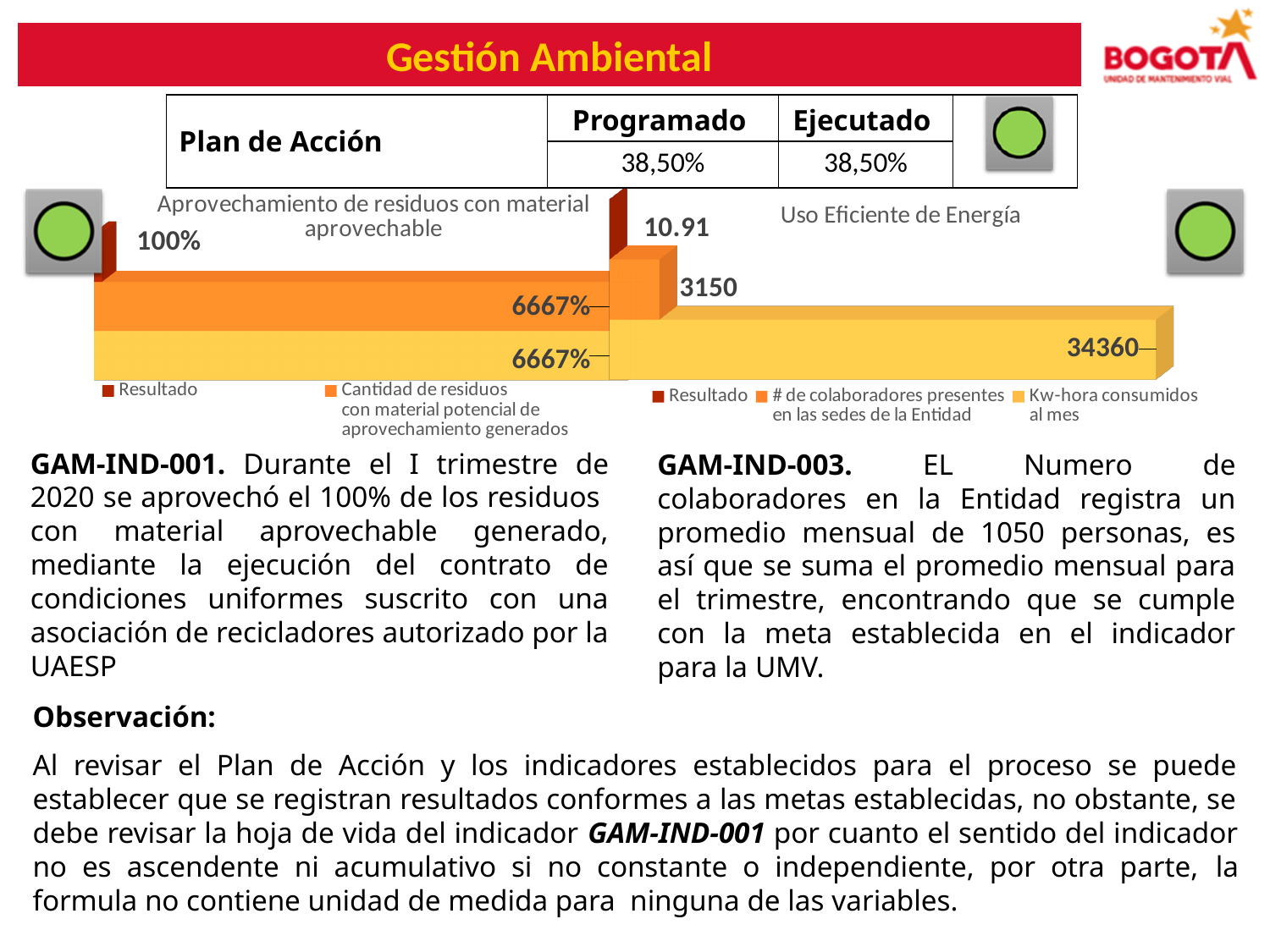
What kind of chart is the chart titled 'Aprovechamiento de residuos con material aprovechable'? Bar chart What is the title of the chart on the right side of the slide? Uso Eficiente de Energía In the chart titled 'Uso Eficiente de Energía', what is the value for 'Resultado'? 10.91 In the chart titled 'Uso Eficiente de Energía', what is the difference between 'Kw-hora consumidos al mes' and '# de colaboradores presentes en las sedes de la Entidad'? 31210 In the chart titled 'Uso Eficiente de Energía', which series has the lowest value? Resultado In the chart titled 'Uso Eficiente de Energía', which is larger: '# de colaboradores presentes en las sedes de la Entidad' or 'Resultado'? # de colaboradores presentes en las sedes de la Entidad How many series does the legend of the chart titled 'Uso Eficiente de Energía' list? 3 In the chart titled 'Uso Eficiente de Energía', which series has the highest value? Kw-hora consumidos al mes How many series does the legend of the chart titled 'Aprovechamiento de residuos con material aprovechable' list? 2 In the chart titled 'Uso Eficiente de Energía', what is the value for 'Kw-hora consumidos al mes'? 34360 In the chart titled 'Aprovechamiento de residuos con material aprovechable', what is the value for 'Resultado'? 100% In the chart titled 'Uso Eficiente de Energía', what is the value for '# de colaboradores presentes en las sedes de la Entidad'? 3150